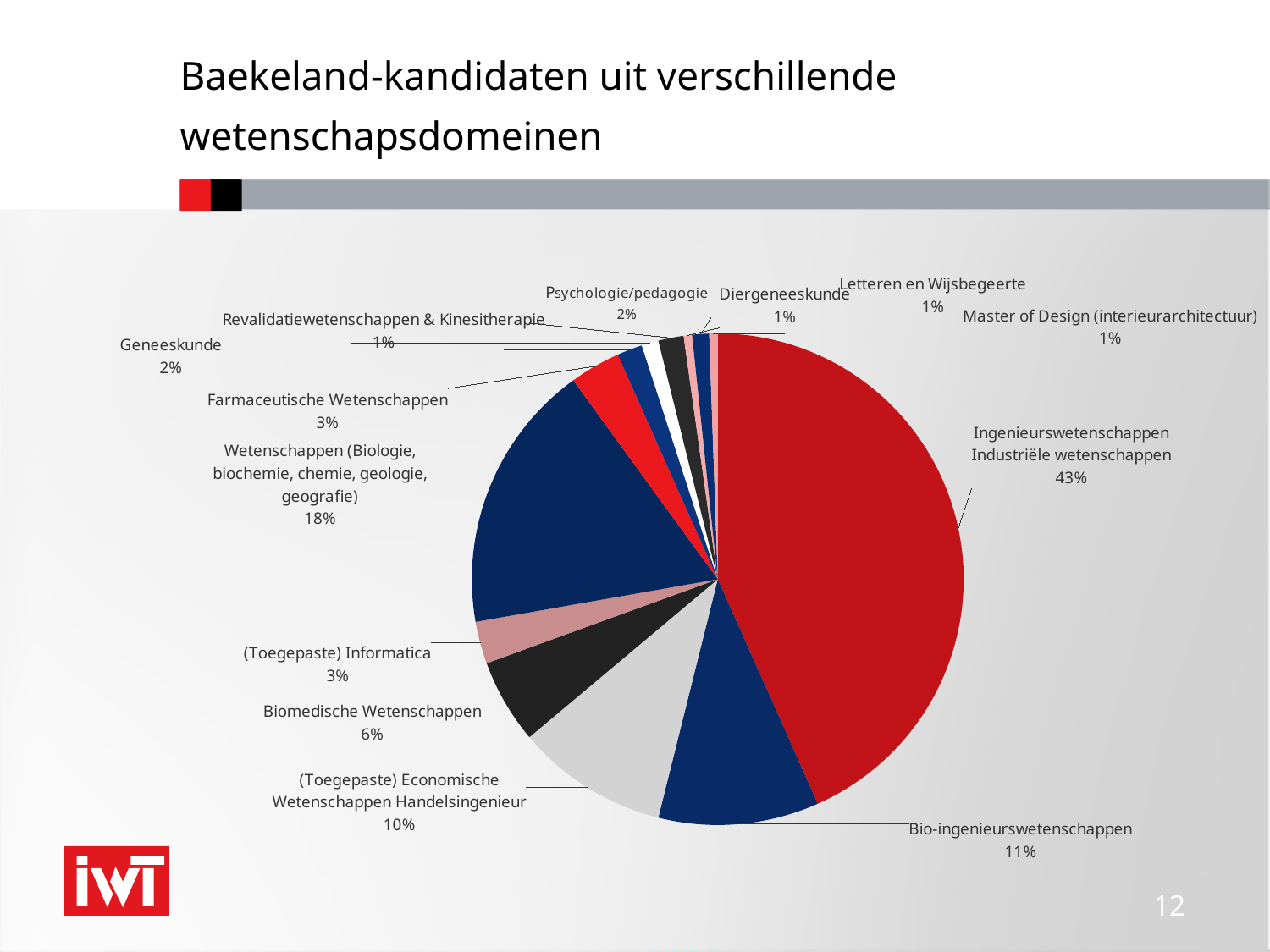
Which category has the largest share of the pie? Ingenieurswetenschappen Industriële wetenschappen What is the value for Biomedische Wetenschappen? 6% What is the value for Bio-ingenieurswetenschappen? 11% What is the difference between the shares of Ingenieurswetenschappen Industriële wetenschappen and Wetenschappen (Biologie, biochemie, chemie, geologie, geografie)? 25% What is the title of the slide containing the pie chart? Baekeland-kandidaten uit verschillende wetenschapsdomeinen Which is larger, the share for Bio-ingenieurswetenschappen or the share for (Toegepaste) Economische Wetenschappen Handelsingenieur? Bio-ingenieurswetenschappen What type of chart is shown on the slide? pie chart What is the value for Wetenschappen (Biologie, biochemie, chemie, geologie, geografie)? 18% What is the value for (Toegepaste) Economische Wetenschappen Handelsingenieur? 10% What is the value for Farmaceutische Wetenschappen? 3% What share of the pie does Ingenieurswetenschappen Industriële wetenschappen represent? 43% How many categories are shown in the pie chart? 13